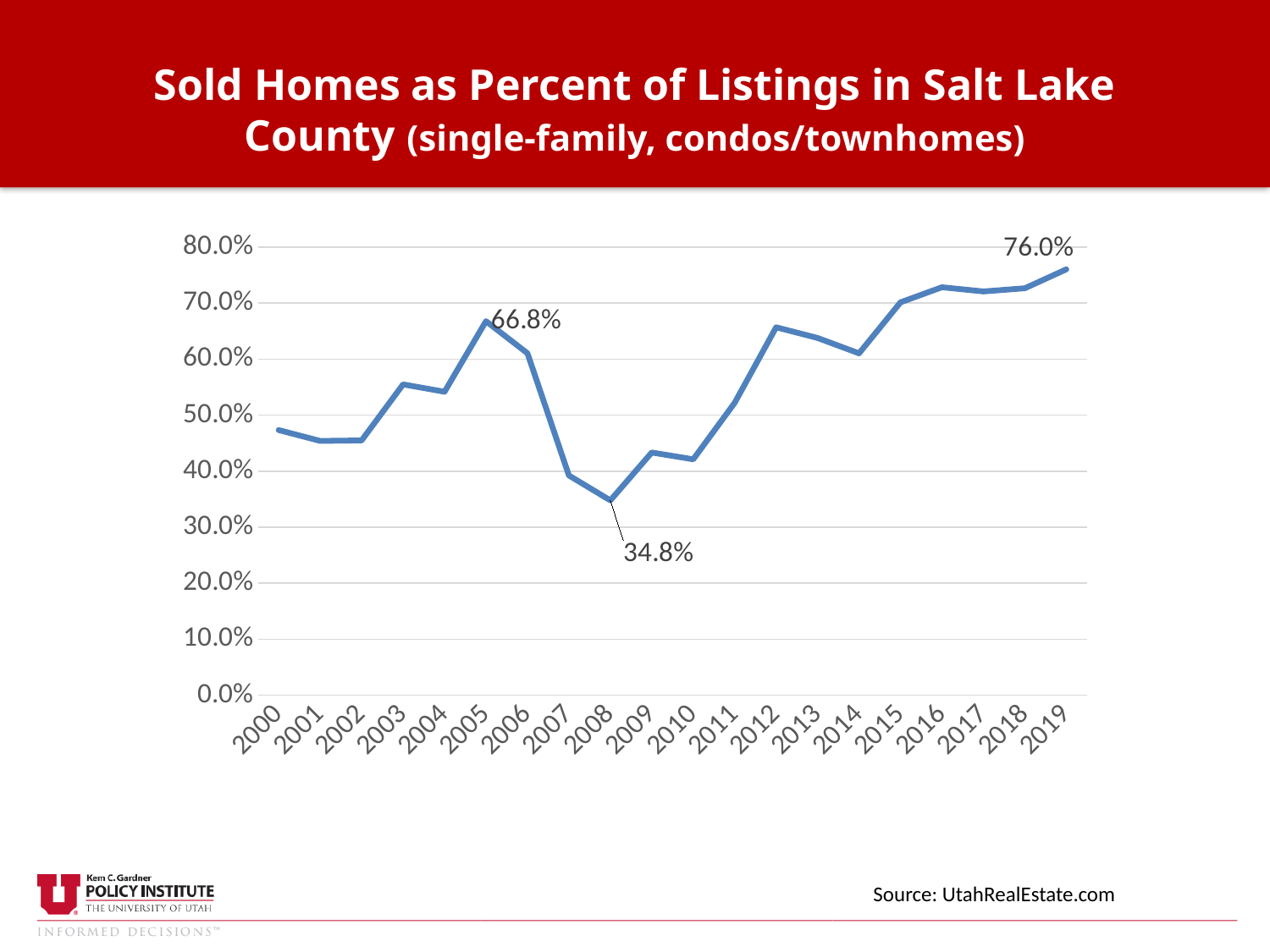
What is the difference between the 2019 value and the 2008 value? 41.2 percentage points Which year has the lowest sold homes as percent of listings? 2008 Which year has a larger value, 2005 or 2019? 2019 What is the sold homes as percent of listings value for 2019? 76.0% Which year has the highest sold homes as percent of listings? 2019 How many years are plotted on the x axis? 20 Is the value for 2016 greater or less than 70.0%? greater What is the value labeled for 2008? 34.8% What is the difference between the 2005 value and the 2008 value? 32.0 percentage points Is the value for 2000 greater or less than 50.0%? less What is the value labeled for 2005? 66.8% What type of chart is shown on the slide? line chart